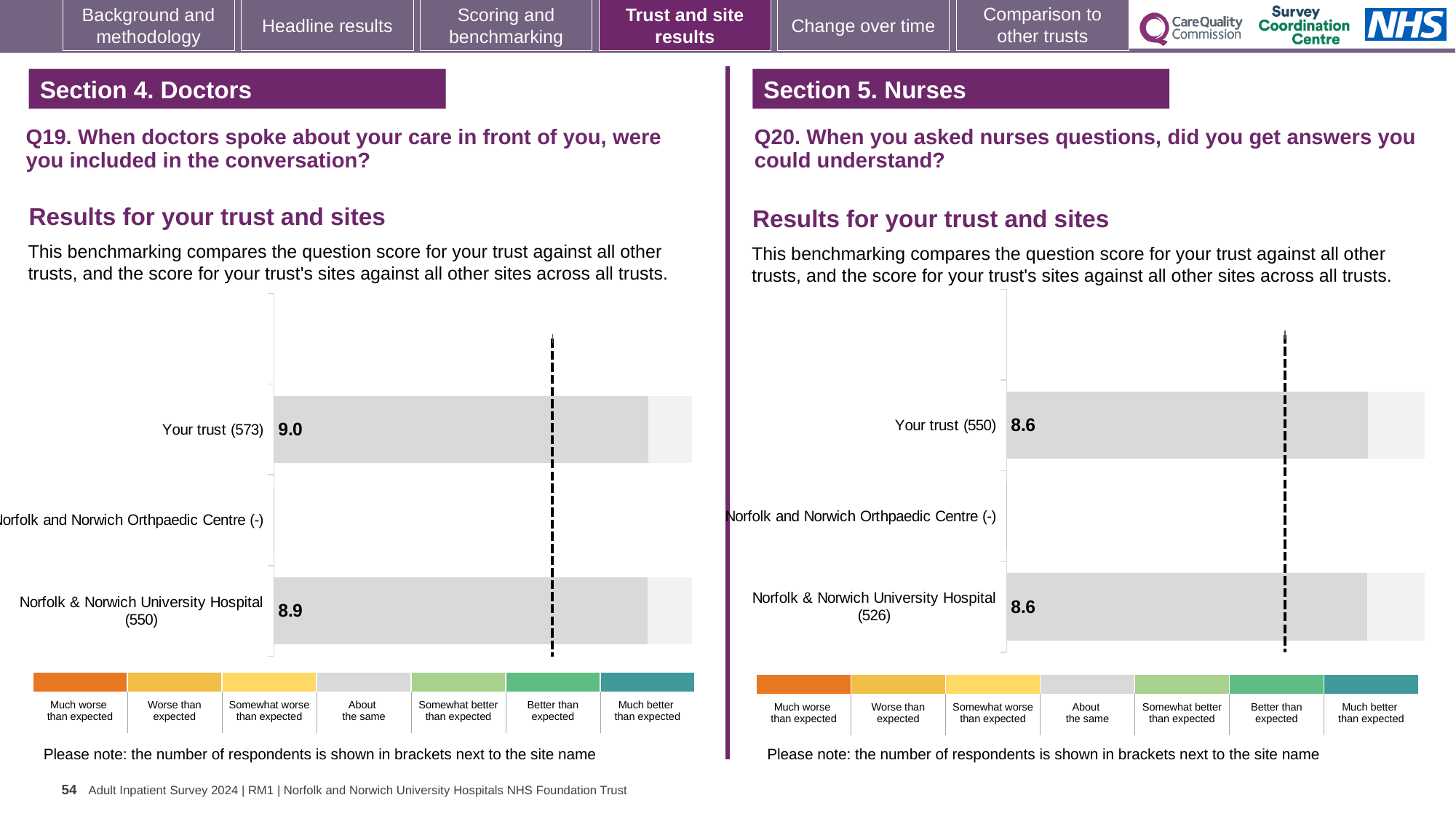
In the Q20 chart on the right, what is the score for Your trust (550)? 8.6 In the Q19 chart on the left, how many categories are listed on the vertical axis? 3 In the Q19 chart on the left, how many respondents are shown in brackets for Norfolk & Norwich University Hospital? 550 In the Q20 chart on the right, what is the difference between the score for Your trust (550) and the score for Norfolk & Norwich University Hospital (526)? 0.0 In the Q20 chart on the right, what is the score for Norfolk & Norwich University Hospital (526)? 8.6 In the Q19 chart on the left, what is the score for Norfolk & Norwich University Hospital (550)? 8.9 What type of chart is used in the Q19 chart on the left? Bar chart In the Q20 chart on the right, which category has no bar plotted? Norfolk and Norwich Orthpaedic Centre (-) In the Q19 chart on the left, what is the score for Your trust (573)? 9.0 In the Q19 chart on the left, what is the difference between the score for Your trust (573) and the score for Norfolk & Norwich University Hospital (550)? 0.1 In the Q20 chart on the right, how many categories are listed on the vertical axis? 3 In the Q19 chart on the left, which has the higher score: Your trust (573) or Norfolk & Norwich University Hospital (550)? Your trust (573)